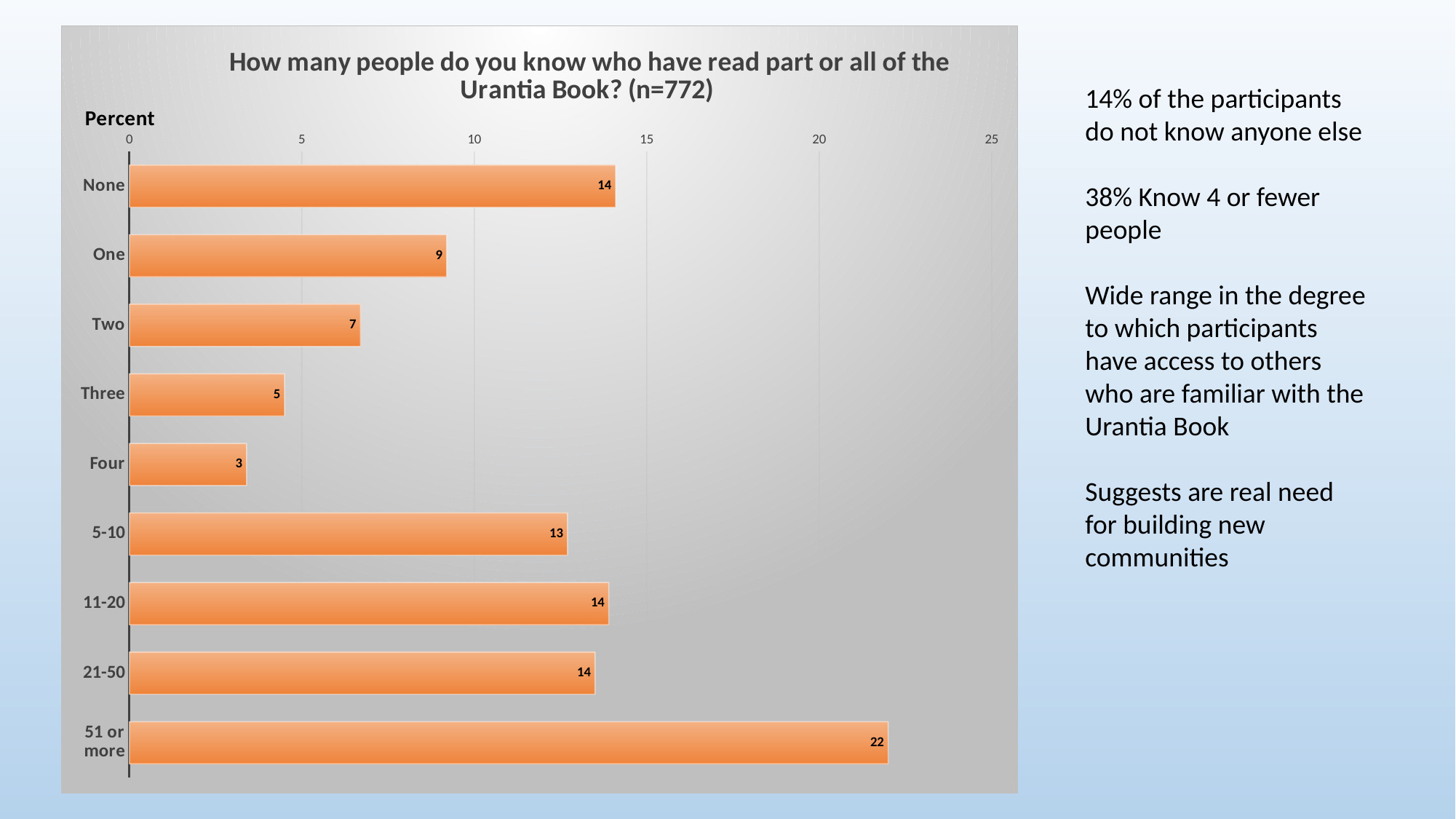
Which category has the lowest value? Four What is the title of the chart? How many people do you know who have read part or all of the Urantia Book? (n=772) What kind of chart is shown on the slide? bar chart Is the value for '51 or more' greater or less than 20? greater What is the value for the '51 or more' category? 22 What is the value for the '5-10' category? 13 Which is larger, the value for 'One' or the value for 'Three'? One How many categories are shown in the chart? 9 Which category has the highest value? 51 or more What is the label on the value axis of the chart? Percent What is the value for the 'Two' category? 7 What is the difference between the values for '51 or more' and 'None'? 8